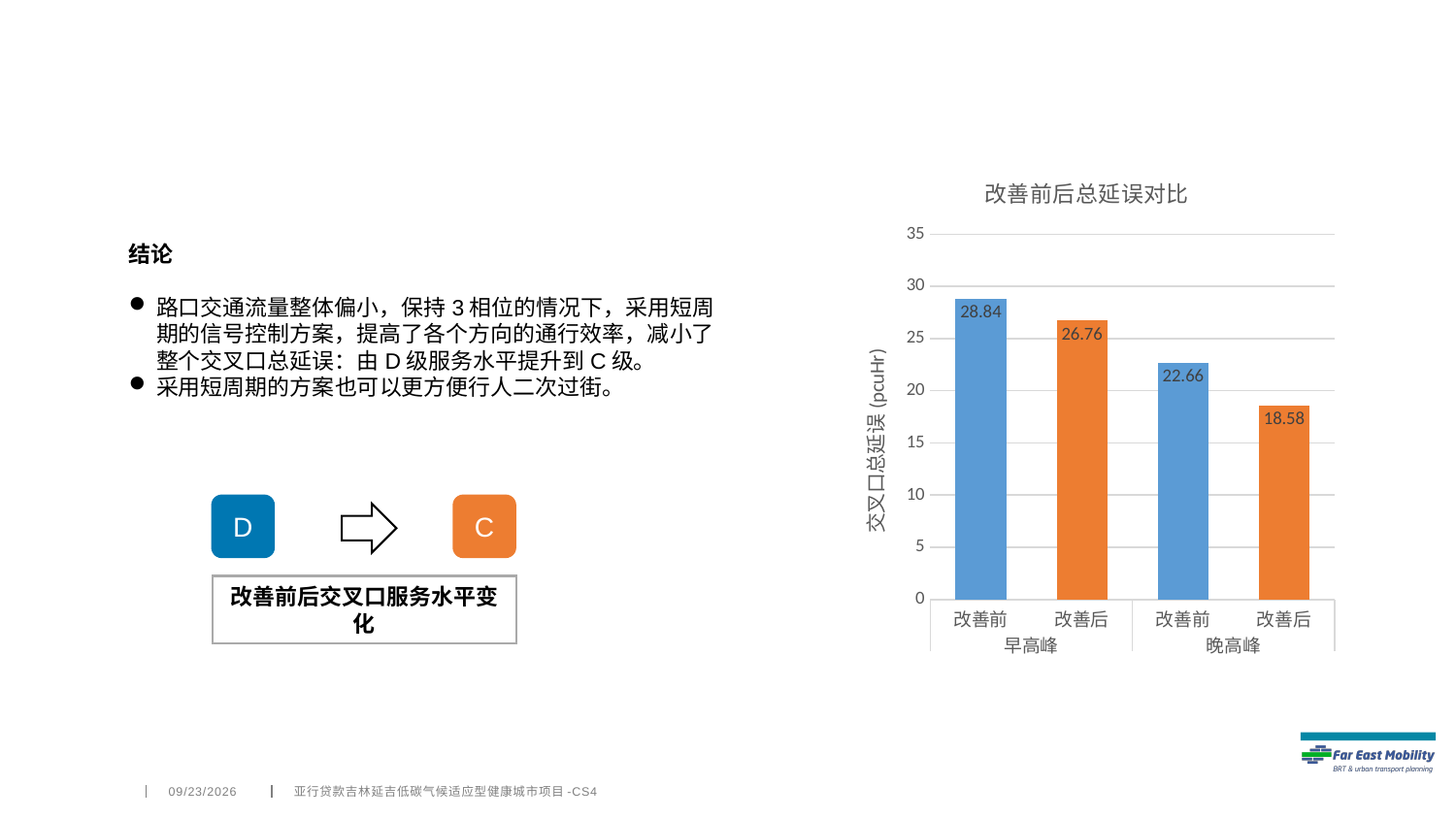
Is the value for 改善后 in the 晚高峰 group greater or less than 20? less Which bar has the highest value? 早高峰 改善前 What is the difference between 改善前 and 改善后 in the 早高峰 group? 2.08 What is the title of the chart? 改善前后总延误对比 How many bars are plotted in the chart? 4 What is the difference between 改善前 and 改善后 in the 晚高峰 group? 4.08 What kind of chart is shown on the slide? bar chart Which is larger, 改善后 in 早高峰 or 改善前 in 晚高峰? 改善后 in 早高峰 What is the value for 改善前 in the 早高峰 group? 28.84 What is the value for 改善后 in the 晚高峰 group? 18.58 Which bar has the lowest value? 晚高峰 改善后 What is the value for 改善前 in the 晚高峰 group? 22.66